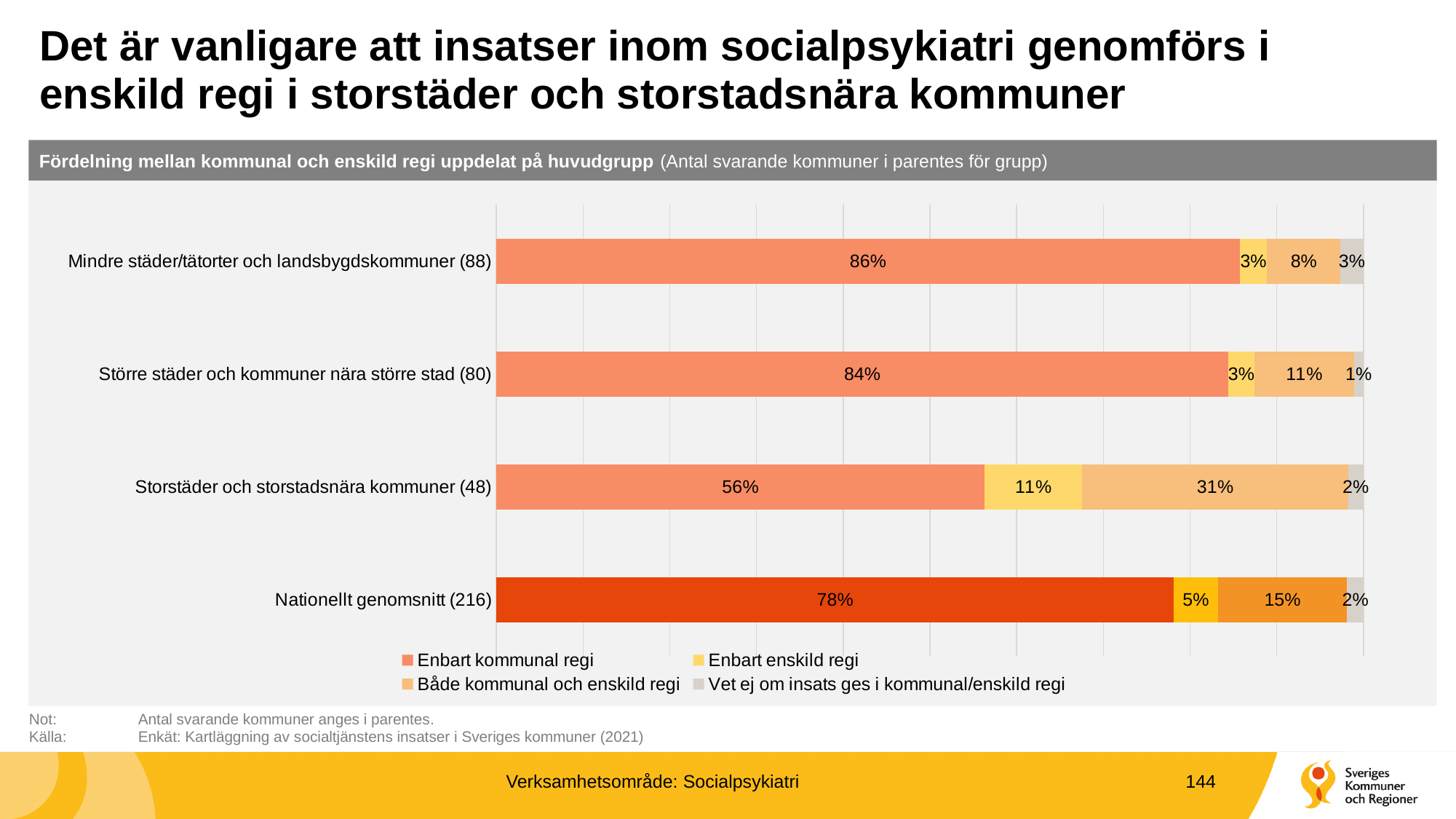
Which is larger: the "Både kommunal och enskild regi" value for Storstäder och storstadsnära kommuner (48) or for Nationellt genomsnitt (216)? Storstäder och storstadsnära kommuner (48) Which category has the highest value for "Enbart kommunal regi"? Mindre städer/tätorter och landsbygdskommuner (88) What is the value for "Både kommunal och enskild regi" for Större städer och kommuner nära större stad (80)? 11% Which series is shown in the grey colour in the legend? Vet ej om insats ges i kommunal/enskild regi How many series does the legend list? 4 Which category has the lowest value for "Både kommunal och enskild regi"? Mindre städer/tätorter och landsbygdskommuner (88) What is the difference between the "Enbart kommunal regi" values for Mindre städer/tätorter och landsbygdskommuner (88) and Storstäder och storstadsnära kommuner (48)? 30 percentage points What kind of chart is shown on the slide? Stacked bar chart What is the value for "Enbart enskild regi" for Nationellt genomsnitt (216)? 5% How many categories (bars) are shown in the chart? 4 What is the value for "Vet ej om insats ges i kommunal/enskild regi" for Mindre städer/tätorter och landsbygdskommuner (88)? 3% What is the value for "Enbart kommunal regi" for Storstäder och storstadsnära kommuner (48)? 56%